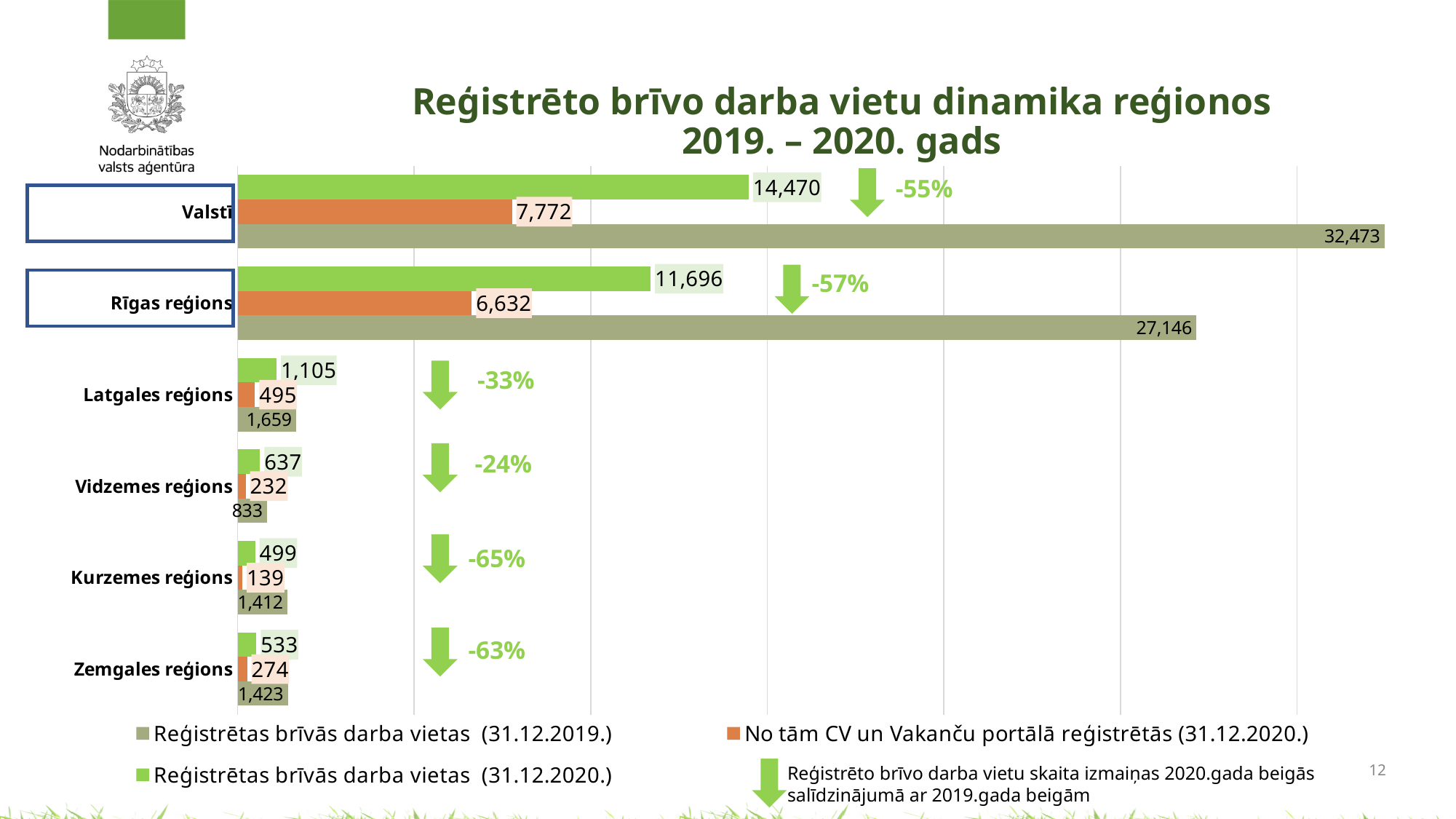
What is the value of 'Reģistrētas brīvās darba vietas (31.12.2019.)' for Vidzemes reģions? 833 What is the value of 'Reģistrētas brīvās darba vietas (31.12.2020.)' for Rīgas reģions? 11,696 Which is larger: the 31.12.2020 registered vacancies for Zemgales reģions or for Kurzemes reģions? Zemgales reģions What is the difference between the 31.12.2019 and 31.12.2020 values of registered vacancies for Valstī? 18,003 What is the value of 'Reģistrētas brīvās darba vietas (31.12.2019.)' for Valstī? 32,473 What percentage change is shown next to the arrow for Kurzemes reģions? -65% What is the value of 'No tām CV un Vakanču portālā reģistrētās (31.12.2020.)' for Latgales reģions? 495 How many data series does the legend list for the bars? 3 Which category has the highest value for 'Reģistrētas brīvās darba vietas (31.12.2019.)'? Valstī How many categories (regions, including Valstī) are shown on the chart? 6 Which region (excluding Valstī) has the lowest value for 'Reģistrētas brīvās darba vietas (31.12.2020.)'? Kurzemes reģions What kind of chart is shown on the slide? bar chart